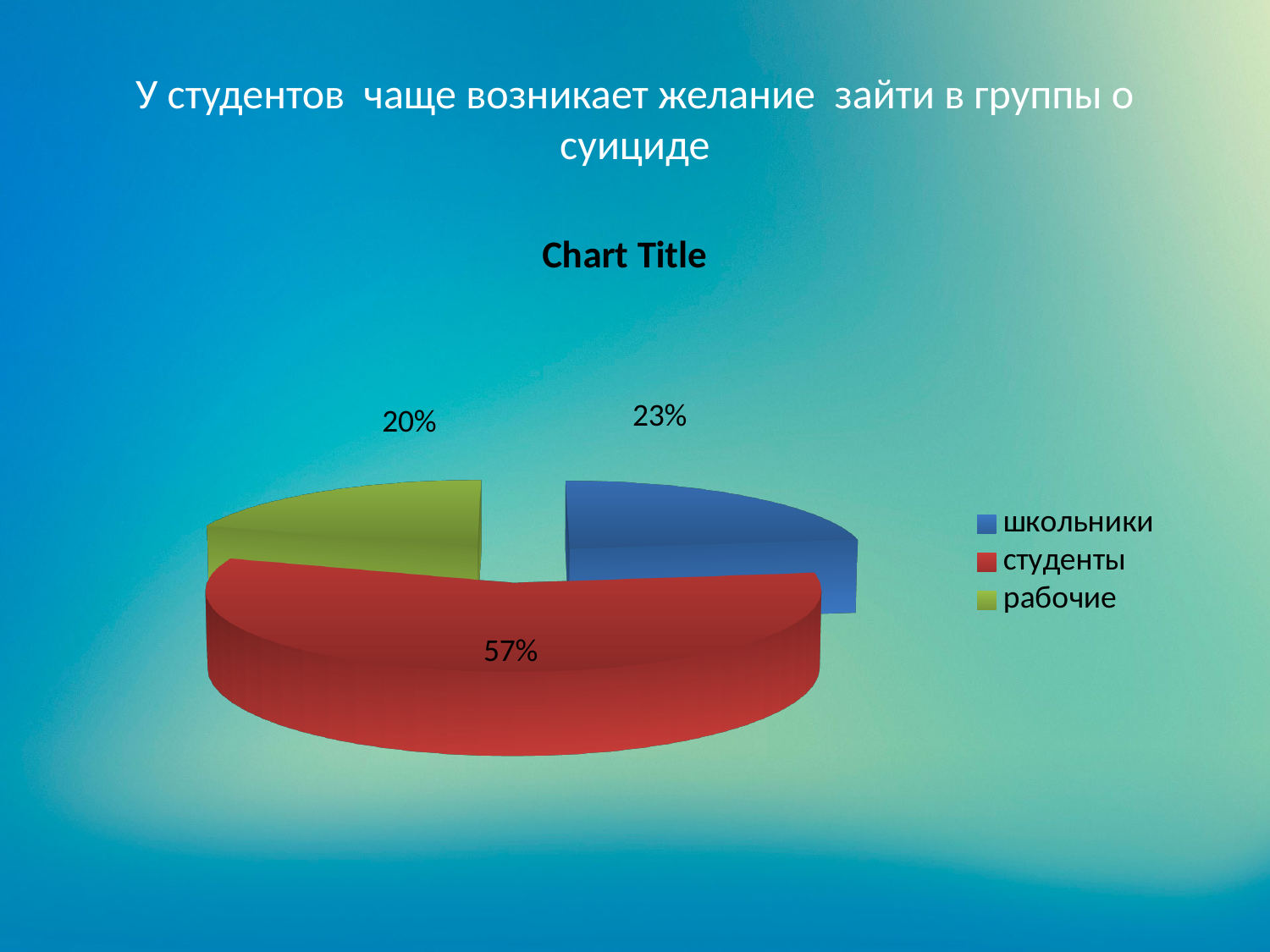
What share of the pie does студенты have? 57% What is the difference between the shares of школьники and рабочие? 3% Which category has the smallest slice of the pie? рабочие How many slices does the pie chart have? 3 What share of the pie does рабочие have? 20% What colour is the slice for студенты? red Which category has the largest slice of the pie? студенты Which is larger, the share for студенты or the share for рабочие? студенты What kind of chart is shown on the slide? pie chart What is the title shown above the pie chart? Chart Title What share of the pie does школьники have? 23% What is the difference between the shares of студенты and школьники? 34%